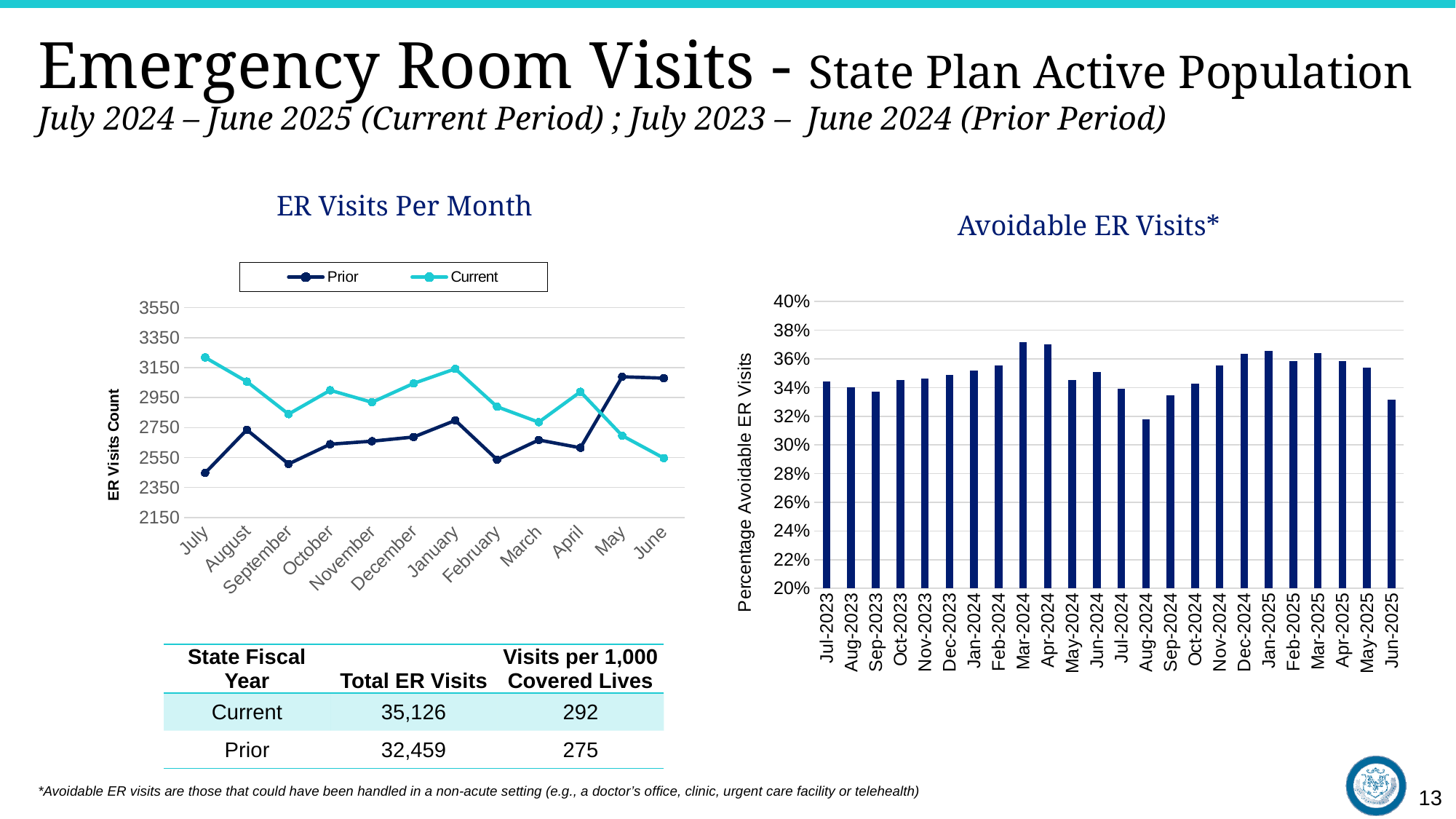
How many series does the legend of the "ER Visits Per Month" chart list? 2 What type of chart is the "ER Visits Per Month" chart? line chart In the "Avoidable ER Visits*" chart, is the value for Mar-2024 greater or less than 36%? greater What type of chart is the "Avoidable ER Visits*" chart? bar chart In the "ER Visits Per Month" chart, which month has the highest value for the Current series? July In the "ER Visits Per Month" chart, is the Current value for July greater or less than 3150? greater In the "ER Visits Per Month" chart, which series has the larger value in June, Prior or Current? Prior In the "Avoidable ER Visits*" chart, which month has the lowest percentage of avoidable ER visits? Aug-2024 In the "ER Visits Per Month" chart, which month has the lowest value for the Prior series? July How many months are plotted on the x axis of the "Avoidable ER Visits*" chart? 24 What is the y-axis label of the "Avoidable ER Visits*" chart? Percentage Avoidable ER Visits